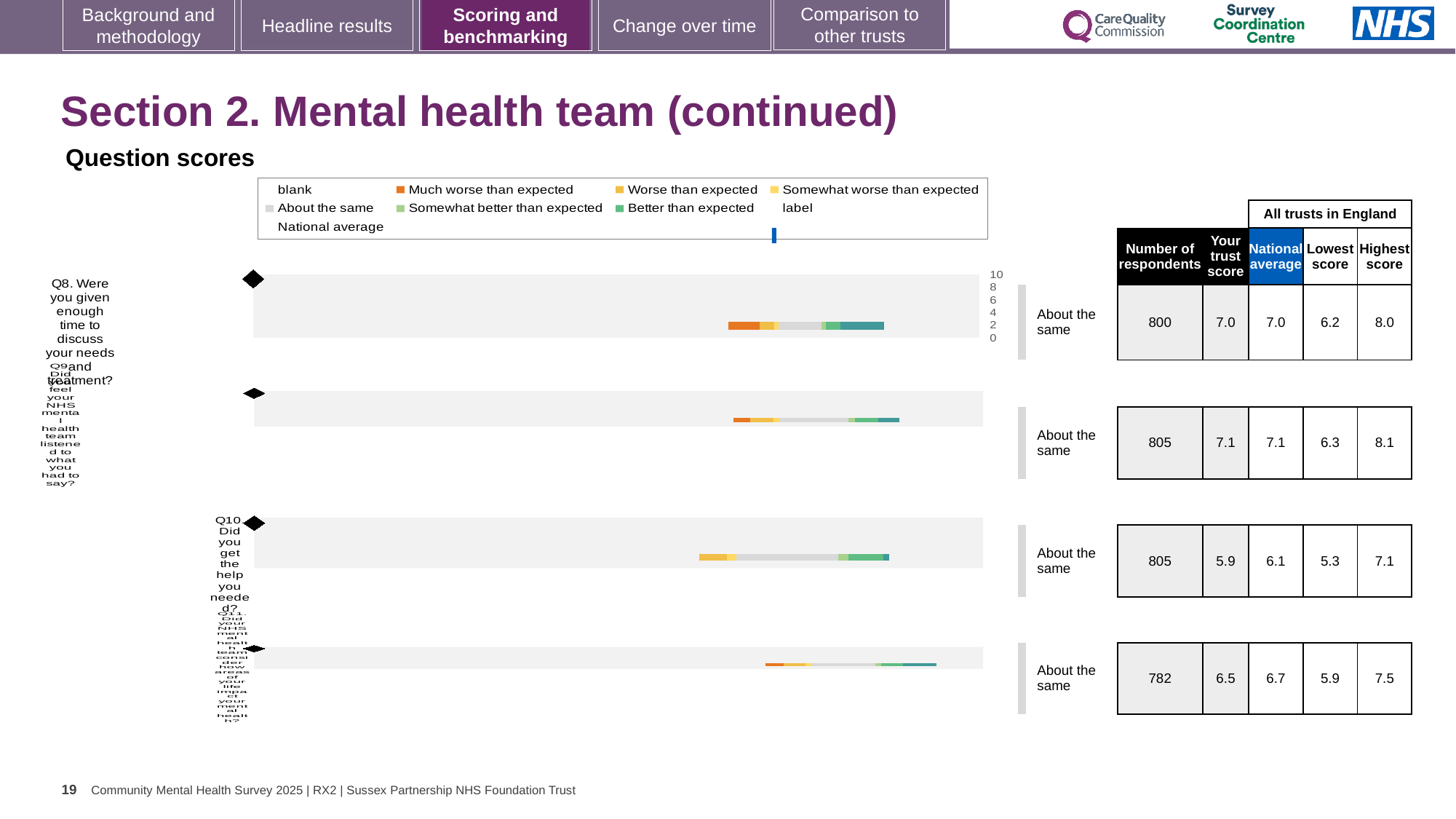
For Q10, what is the national average score? 6.1 For Q8, what is the lowest score among all trusts in England? 6.2 How many question charts are shown on the slide? 4 What colour does the legend use for 'Much worse than expected'? orange What benchmark label is shown next to the Q8 chart? About the same For Q8 (Were you given enough time to discuss your needs and treatment?), what is the number of respondents? 800 For Q10, what is the difference between the highest score and the lowest score among all trusts in England? 1.8 For Q8, what is the 'Your trust score' value? 7.0 For Q10, which is larger: the trust score or the national average? national average Which row of the table has the lowest number of respondents? the fourth row (Q11), 782 What kind of chart is used to show the question scores on this slide? bar chart For Q10 (Did you get the help you needed?), what is the 'Your trust score' value? 5.9